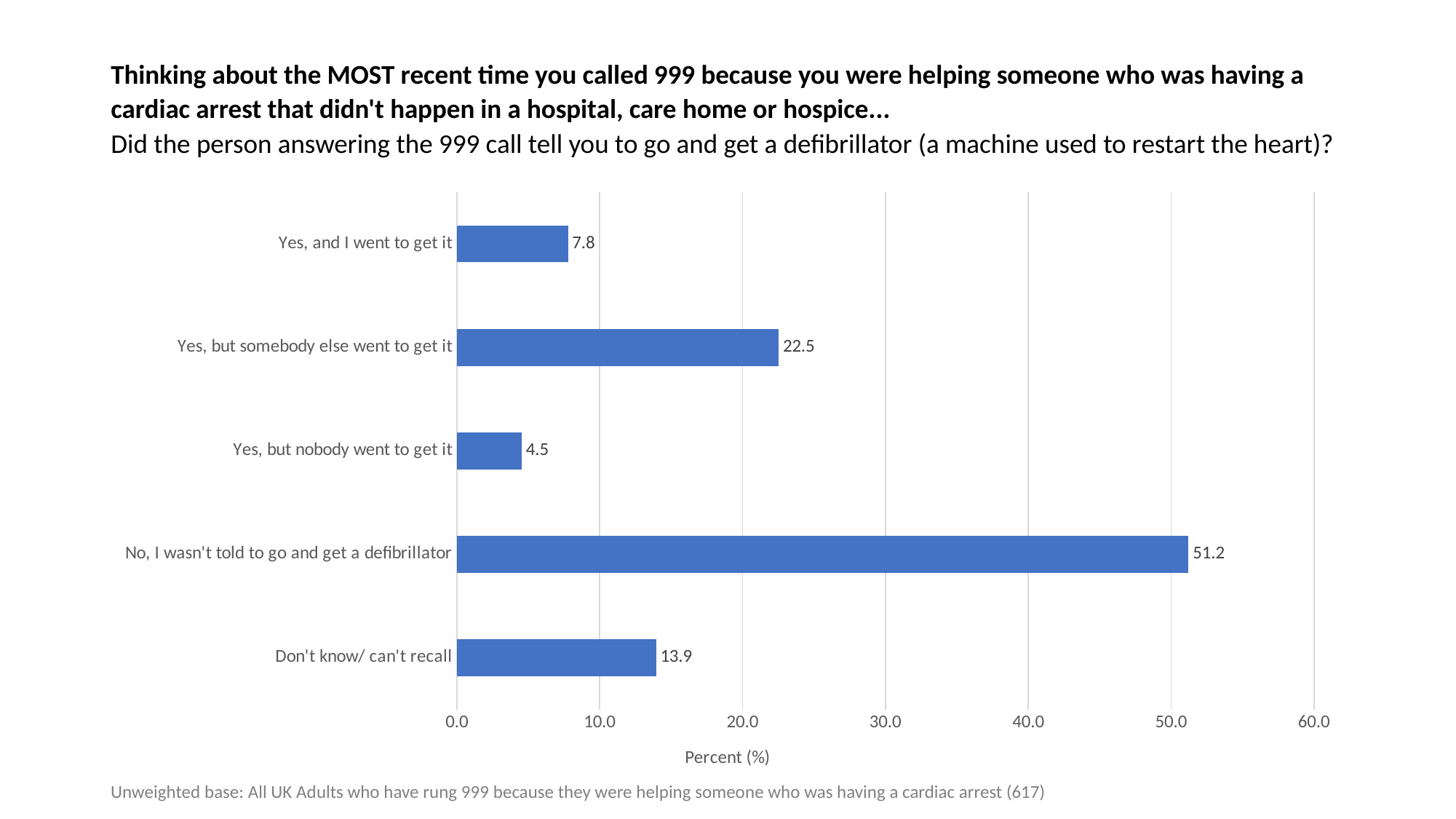
Which is larger: the value for "Yes, and I went to get it" or the value for "Yes, but nobody went to get it"? Yes, and I went to get it What is the label of the horizontal axis? Percent (%) What is the value for "Don't know/ can't recall"? 13.9 Which category has the lowest value? Yes, but nobody went to get it How many categories are shown in the chart? 5 What is the difference between the values for "No, I wasn't told to go and get a defibrillator" and "Yes, but somebody else went to get it"? 28.7 What is the difference between the values for "Don't know/ can't recall" and "Yes, and I went to get it"? 6.1 What is the value for "Yes, but somebody else went to get it"? 22.5 What kind of chart is shown on the slide? Bar chart Which category has the highest value? No, I wasn't told to go and get a defibrillator What is the value for "Yes, and I went to get it"? 7.8 Is the value for "No, I wasn't told to go and get a defibrillator" greater or less than 50.0? greater